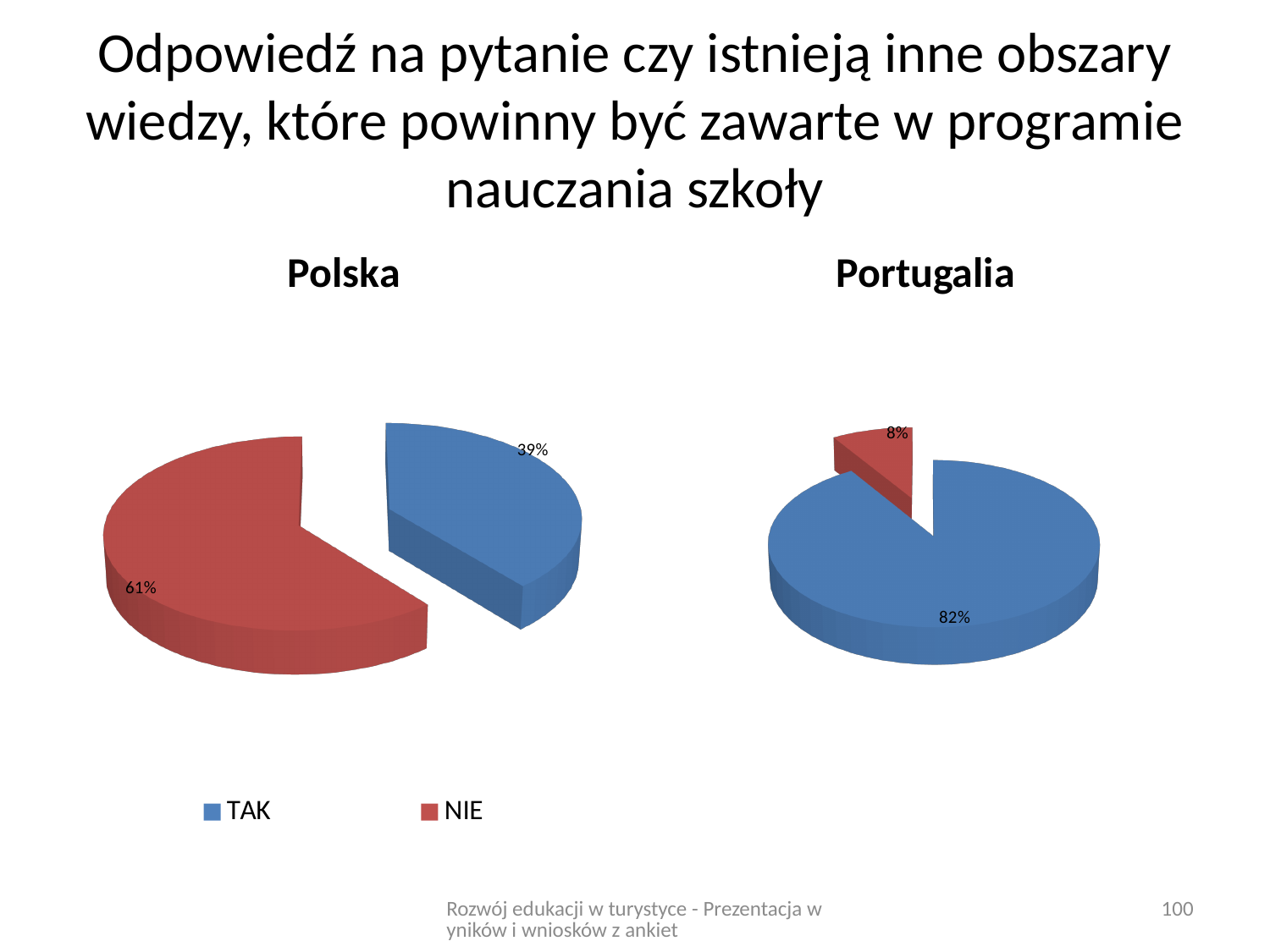
In the Portugalia chart, which answer has the smaller share? NIE In the Portugalia chart, what percentage is shown for TAK? 82% Is the TAK share larger in the Polska chart or in the Portugalia chart? Portugalia Which colour represents TAK in the legend? Blue In the Polska chart, which answer has the larger share? NIE What type of chart is used for the Polska data? Pie chart In the Polska chart, what is the difference between the NIE and TAK shares? 22% In the Portugalia chart, what percentage is shown for NIE? 8% In the Polska chart, what percentage is shown for TAK? 39% In the Polska chart, what percentage is shown for NIE? 61% How many entries does the legend list? 2 In the Portugalia chart, what is the difference between the TAK and NIE shares? 74%